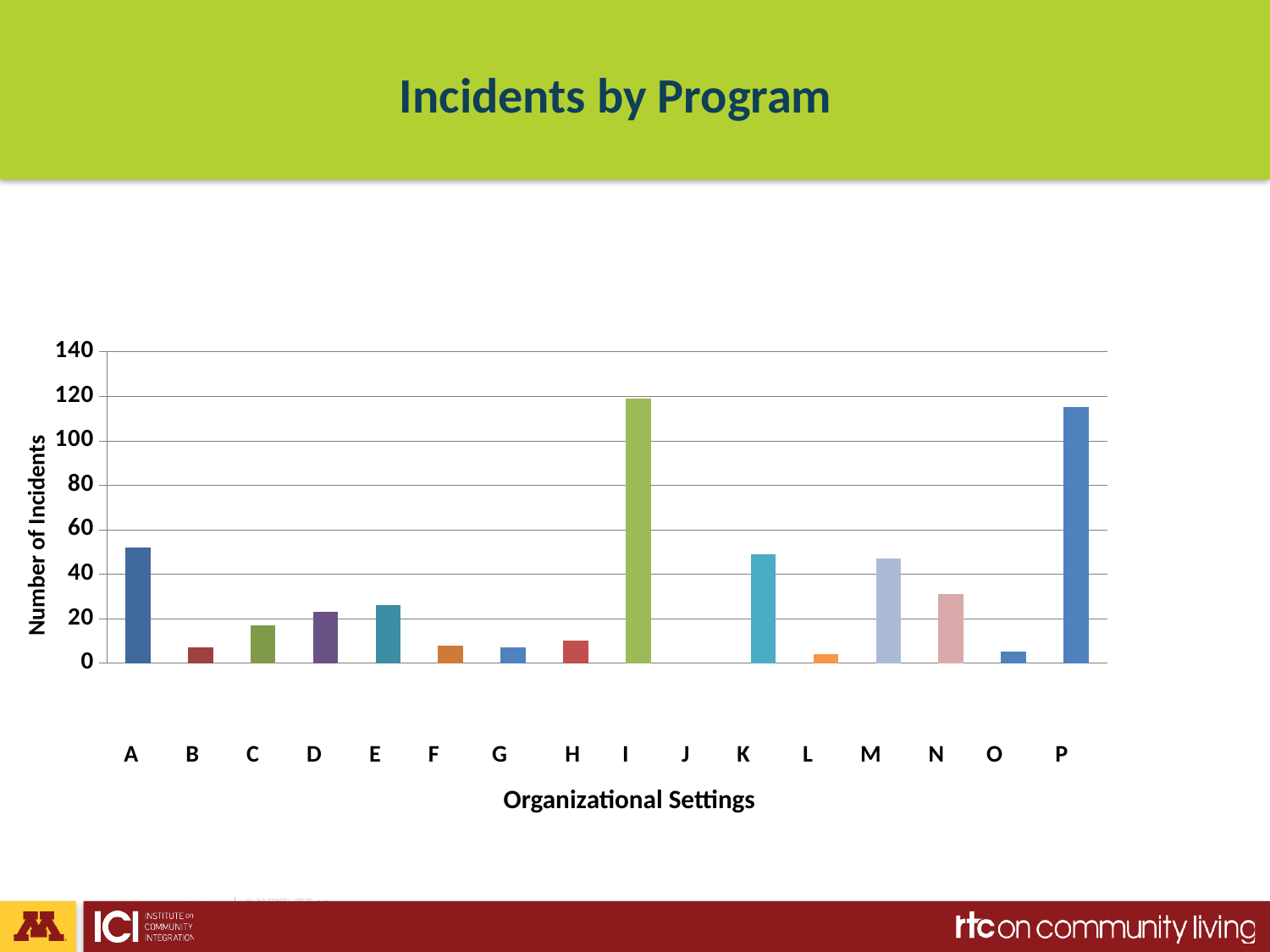
Is the number of incidents for setting I greater or less than 100? greater How many organizational settings (categories) are shown on the x axis? 16 Which has more incidents, setting P or setting K? P Is the number of incidents for setting H greater or less than 20? less Is the number of incidents for setting B greater or less than 20? less Which has more incidents, setting A or setting N? A What is the label of the y axis? Number of Incidents Which organizational setting has the highest number of incidents? I What kind of chart is shown on the slide? Bar chart